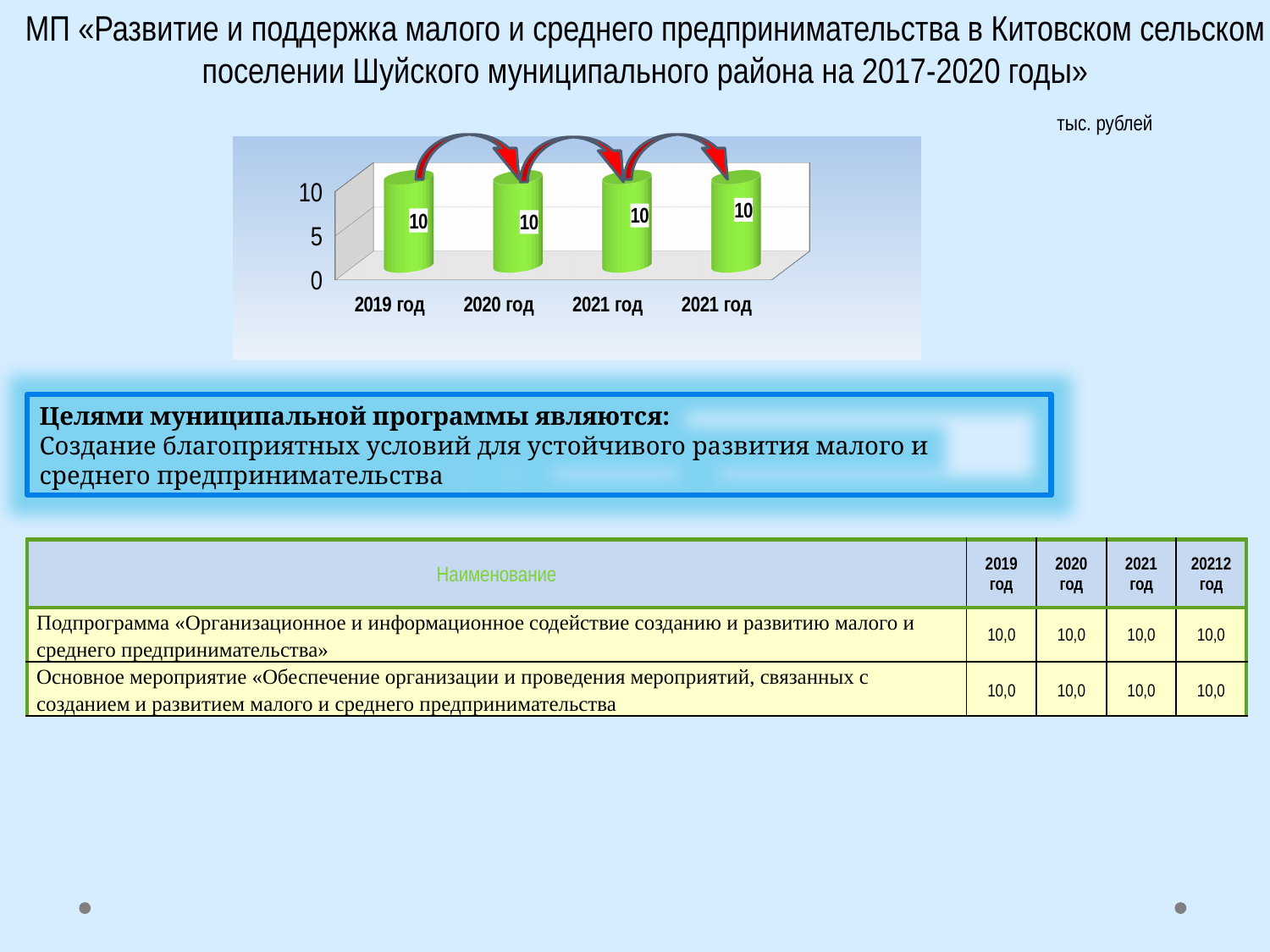
Is the value for 2019 год in the chart greater or less than 5? greater What value is labelled on the bars for 2021 год in the chart? 10 What unit label is shown above the chart? тыс. рублей What kind of chart is shown on the slide? bar chart How many bars are plotted in the chart? 4 What is the highest tick value shown on the vertical axis of the chart? 10 What is the value shown for 2019 год in the chart? 10 Which is larger in the chart, the value for 2019 год or the value for 2020 год? they are equal What is the value shown for 2020 год in the chart? 10 Do the values in the chart rise, fall or stay the same from 2019 год to the last category? stay the same What is the difference between the values for 2019 год and 2020 год in the chart? 0